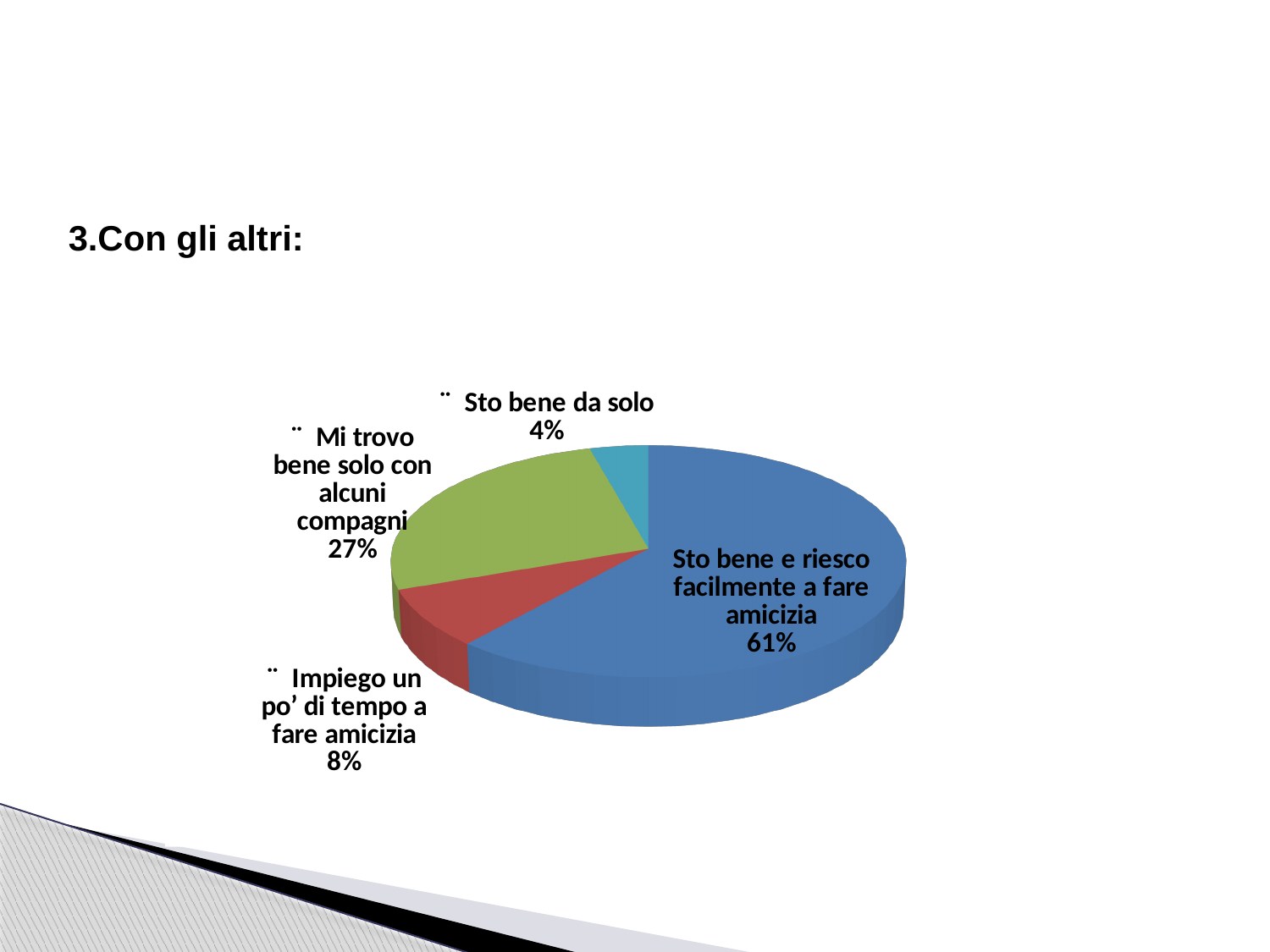
What is the difference in percentage points between "Mi trovo bene solo con alcuni compagni" and "Impiego un po' di tempo a fare amicizia"? 19 What is the difference in percentage points between "Sto bene e riesco facilmente a fare amicizia" and "Mi trovo bene solo con alcuni compagni"? 34 How many slices does the pie chart have? 4 What colour is the slice for "Sto bene e riesco facilmente a fare amicizia"? blue Which category has the smallest slice of the pie? Sto bene da solo What kind of chart is shown on the slide? pie chart What share of the pie does "Impiego un po' di tempo a fare amicizia" have? 8% What share of the pie does "Mi trovo bene solo con alcuni compagni" have? 27% Which is larger: the slice for "Impiego un po' di tempo a fare amicizia" or the slice for "Sto bene da solo"? Impiego un po' di tempo a fare amicizia Which category has the largest slice of the pie? Sto bene e riesco facilmente a fare amicizia What share of the pie does "Sto bene da solo" have? 4%